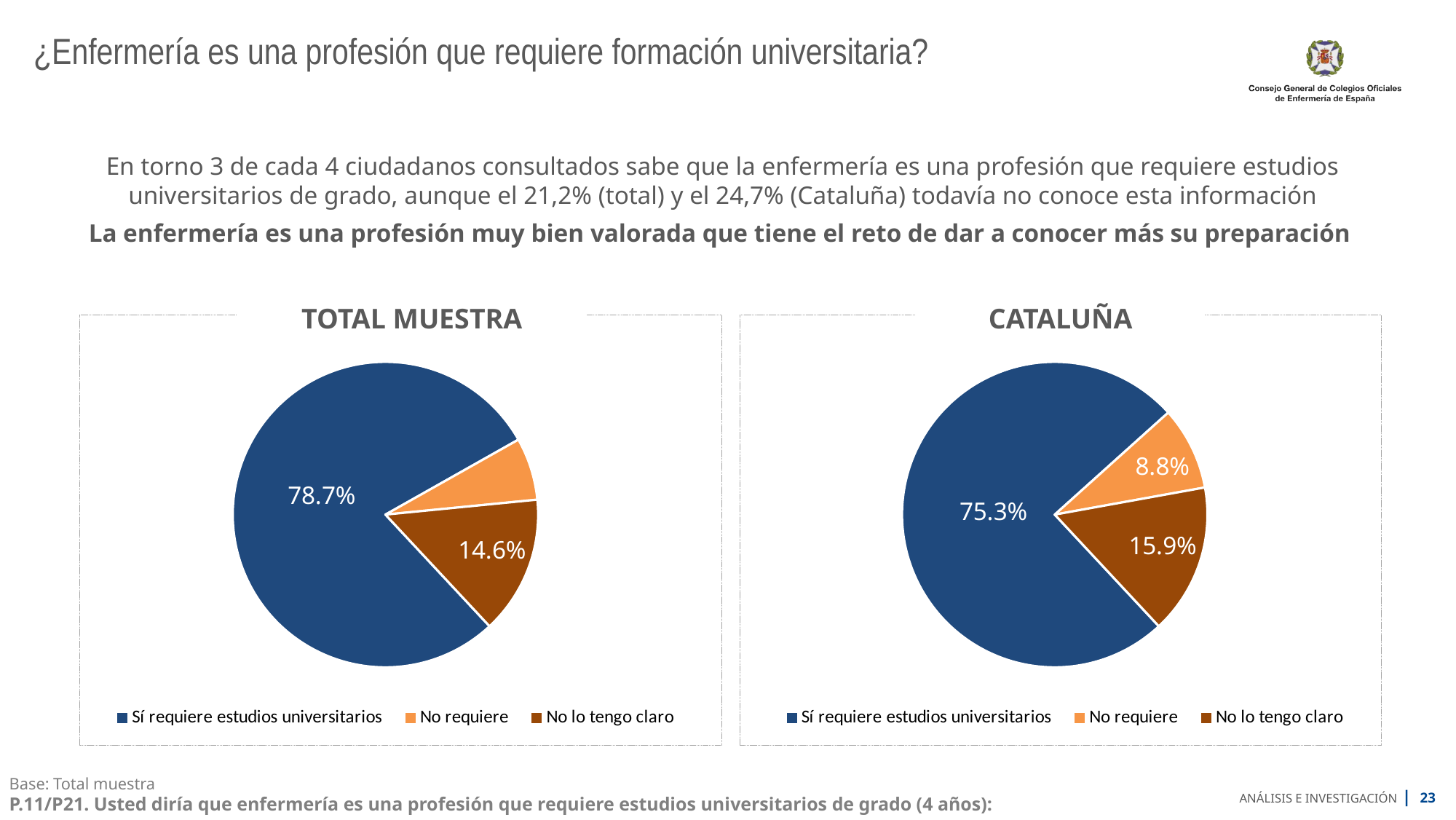
In the CATALUÑA chart, what is the difference between 'No lo tengo claro' and 'No requiere'? 7.1% In the TOTAL MUESTRA chart, what percentage is shown for 'No lo tengo claro'? 14.6% In the TOTAL MUESTRA chart, which category has the largest slice? Sí requiere estudios universitarios How many categories does the legend of the TOTAL MUESTRA chart list? 3 In the CATALUÑA chart, what percentage is shown for 'No requiere'? 8.8% Which chart shows a larger share for 'Sí requiere estudios universitarios', TOTAL MUESTRA or CATALUÑA? TOTAL MUESTRA In the TOTAL MUESTRA chart, what percentage is shown for 'Sí requiere estudios universitarios'? 78.7% What type of chart is used for CATALUÑA? Pie chart In the CATALUÑA chart, what percentage is shown for 'Sí requiere estudios universitarios'? 75.3% In the CATALUÑA chart, which category has the smallest slice? No requiere In the CATALUÑA chart, what colour is the 'No lo tengo claro' slice? Brown In the CATALUÑA chart, what percentage is shown for 'No lo tengo claro'? 15.9%